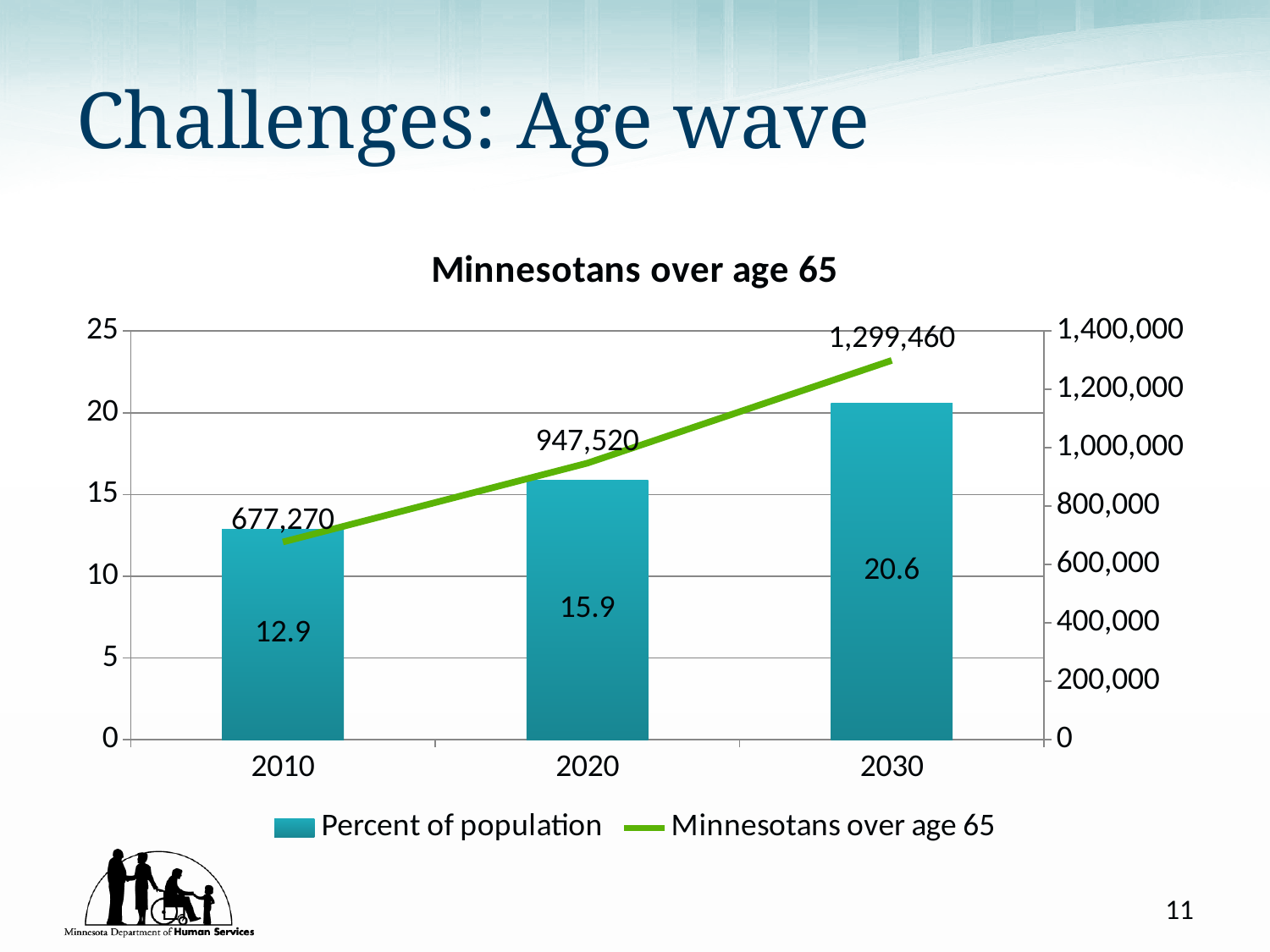
Which year has the highest Percent of population? 2030 What is the difference in Minnesotans over age 65 between 2020 and 2010? 270,250 Does the Minnesotans over age 65 line rise or fall from 2010 to 2030? rise Which year has a larger Percent of population, 2010 or 2020? 2020 What is the Minnesotans over age 65 value for 2010? 677,270 What is the Minnesotans over age 65 value for 2030? 1,299,460 Which year has the lowest Minnesotans over age 65 value? 2010 What is the Percent of population value for 2020? 15.9 What is the title of the chart? Minnesotans over age 65 What is the difference in Percent of population between 2030 and 2010? 7.7 How many years are shown on the x axis? 3 How many series does the legend list? 2